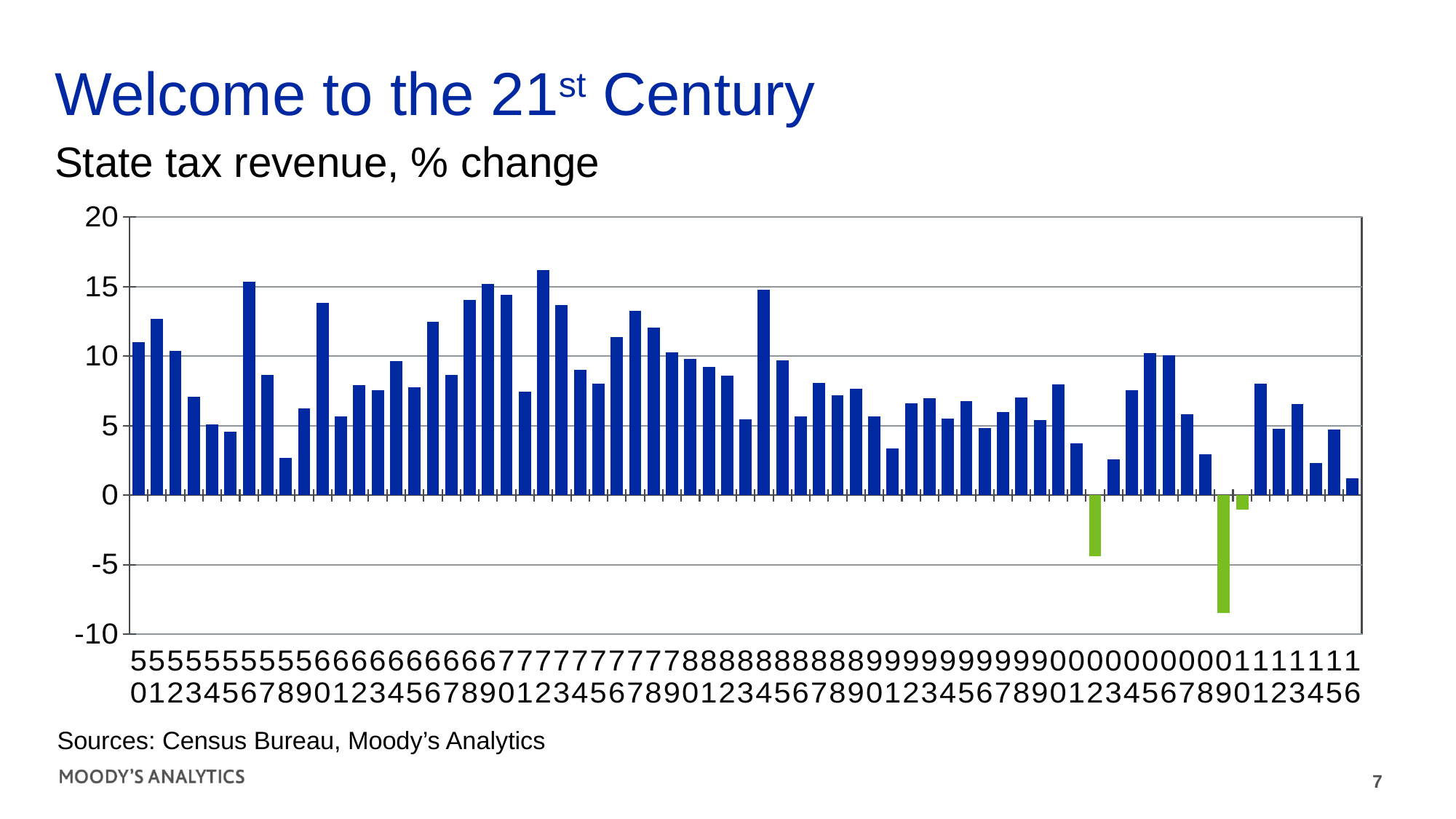
Which year has the lowest value in the chart? 2009 How many bars in the chart have negative values? 3 How many years (bars) are plotted in the chart? 67 Is the value for 2002 greater or less than -5? greater Is the value for 2009 greater or less than -5? less In which decade does the tallest bar in the chart appear? 1970s What kind of chart is shown on the slide? bar chart Do the values generally rise or fall from the 1950s to the 2010s? fall Is the value for 1950 greater or less than 10? greater What is the subtitle describing the data plotted in the chart? State tax revenue, % change Which is larger, the value for 1950 or the value for 2016? 1950 What colour are the bars with negative values? green